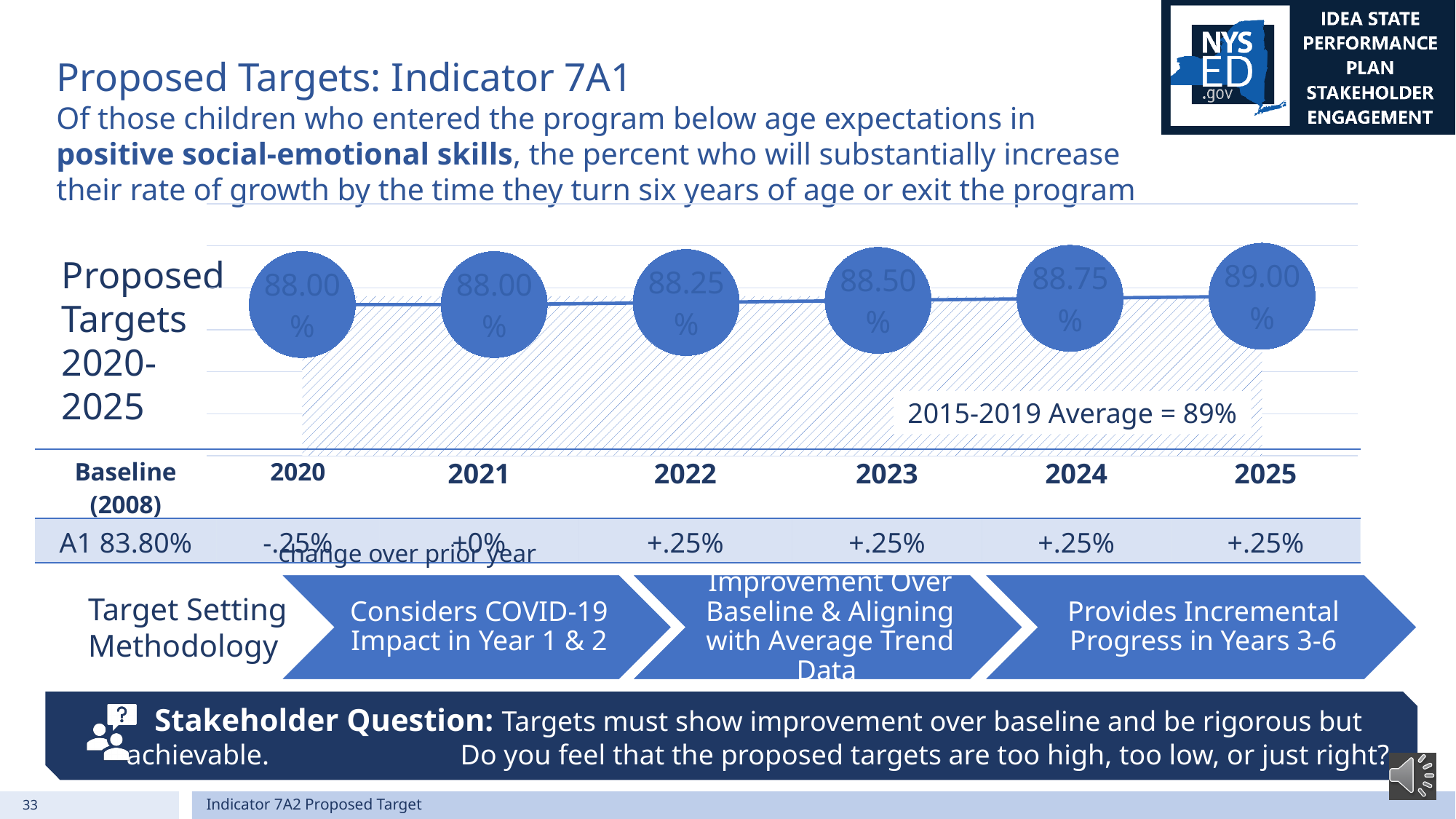
What is the change over prior year shown for 2020? -.25% What is the proposed target for 2020? 88.00% Do the proposed targets rise or fall from 2021 to 2025? rise What is the baseline (2008) value shown below the chart? 83.80% What is the proposed target for 2025? 89.00% What is the proposed target for 2022? 88.25% How many years of proposed targets are plotted on the chart? 6 Which year has the highest proposed target? 2025 What is the difference between the proposed targets for 2025 and 2020? 1.00% Which is larger, the proposed target for 2023 or for 2021? 2023 What is the 2015-2019 average shown on the chart? 89% What is the difference between the proposed targets for 2024 and 2023? 0.25%